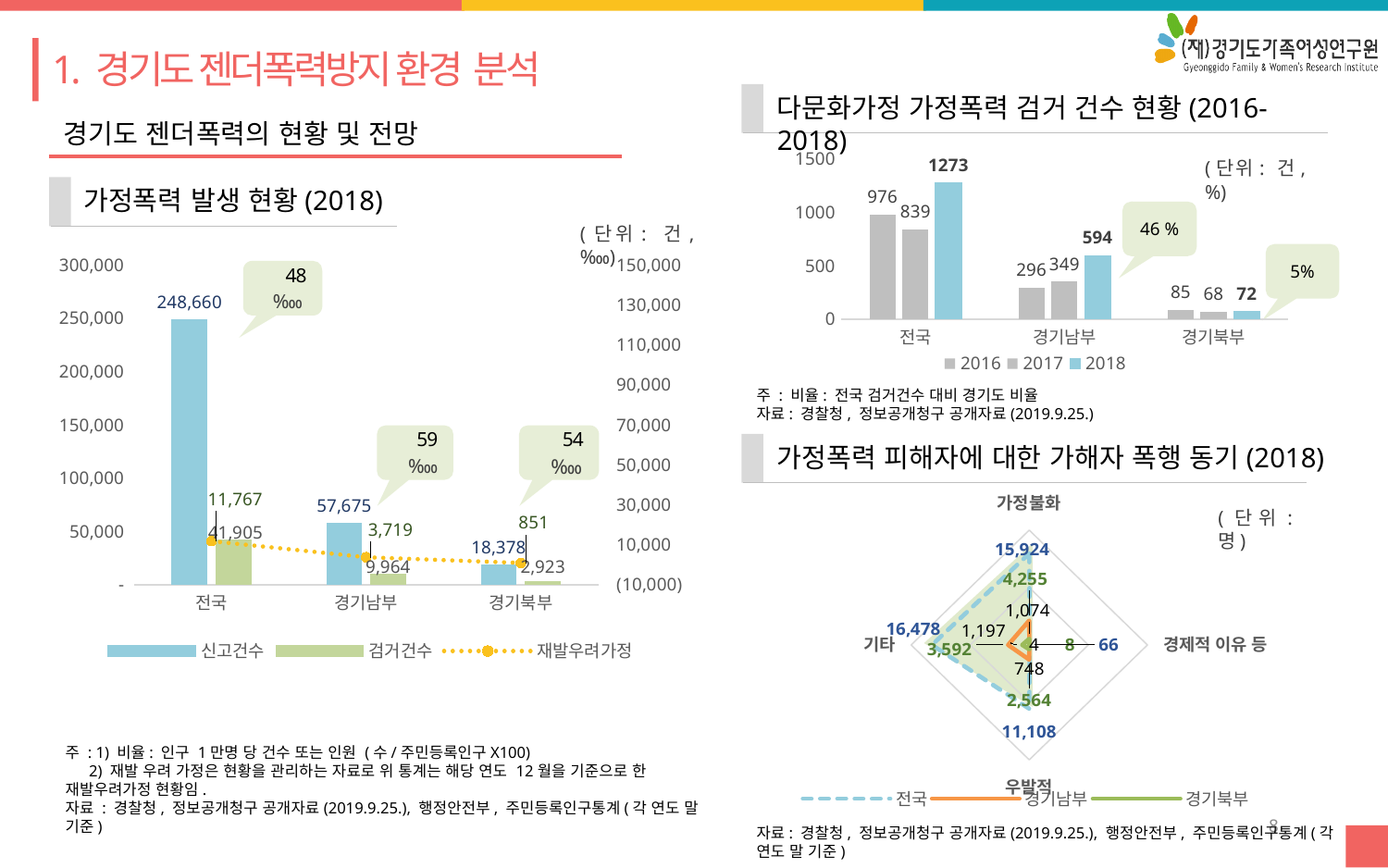
In the chart titled '다문화가정 가정폭력 검거 건수 현황 (2016-2018)', which year has the lowest value for 경기북부? 2017 In the chart titled '가정폭력 발생 현황 (2018)', what is the 재발우려가정 value for 경기북부? 851 In the chart titled '가정폭력 피해자에 대한 가해자 폭행 동기 (2018)', what is the 경기남부 value for 우발적? 2,564 In the chart titled '다문화가정 가정폭력 검거 건수 현황 (2016-2018)', is the 2016 value for 전국 greater or less than 1000? less In the chart titled '가정폭력 발생 현황 (2018)', what is the difference between the 신고건수 values for 경기남부 and 경기북부? 39,297 In the chart titled '가정폭력 피해자에 대한 가해자 폭행 동기 (2018)', which is larger for 경기북부: 가정불화 or 우발적? 가정불화 In the chart titled '다문화가정 가정폭력 검거 건수 현황 (2016-2018)', what is the 2018 value for 전국? 1273 In the chart titled '가정폭력 발생 현황 (2018)', what is the 신고건수 value for 전국? 248,660 In the chart titled '다문화가정 가정폭력 검거 건수 현황 (2016-2018)', what is the 2017 value for 경기남부? 349 In the chart titled '가정폭력 발생 현황 (2018)', how many series does the legend list? 3 In the chart titled '가정폭력 발생 현황 (2018)', what is the 검거건수 value for 경기남부? 9,964 In the chart titled '가정폭력 피해자에 대한 가해자 폭행 동기 (2018)', what is the 전국 value for 기타? 16,478